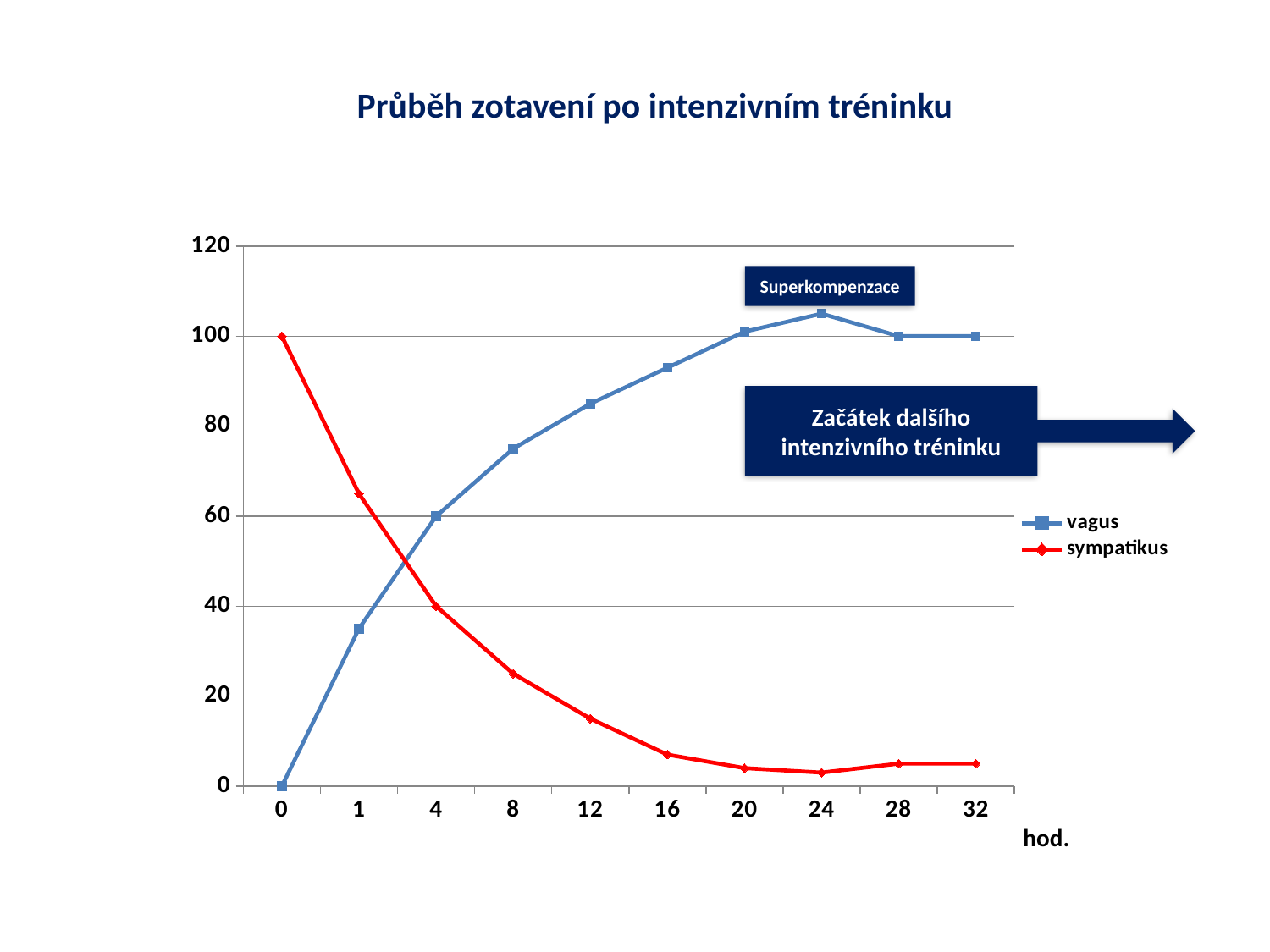
How many series does the legend list? 2 Is the value of the sympatikus series at 12 hours greater or less than 20? less Does the vagus line rise or fall along the x axis from 0 to 24 hours? rise What is the value of the vagus series at 0 hours? 0 What is the value of the sympatikus series at 0 hours? 100 How many points along the x axis does each line have? 10 Is the value of the vagus series at 8 hours greater or less than 60? greater What kind of chart is shown on the slide? line chart What is the title of the chart? Průběh zotavení po intenzivním tréninku Does the sympatikus line rise or fall along the x axis from 0 to 24 hours? fall At 1 hour, which series has the larger value, vagus or sympatikus? sympatikus What is the value of the vagus series at 32 hours? 100